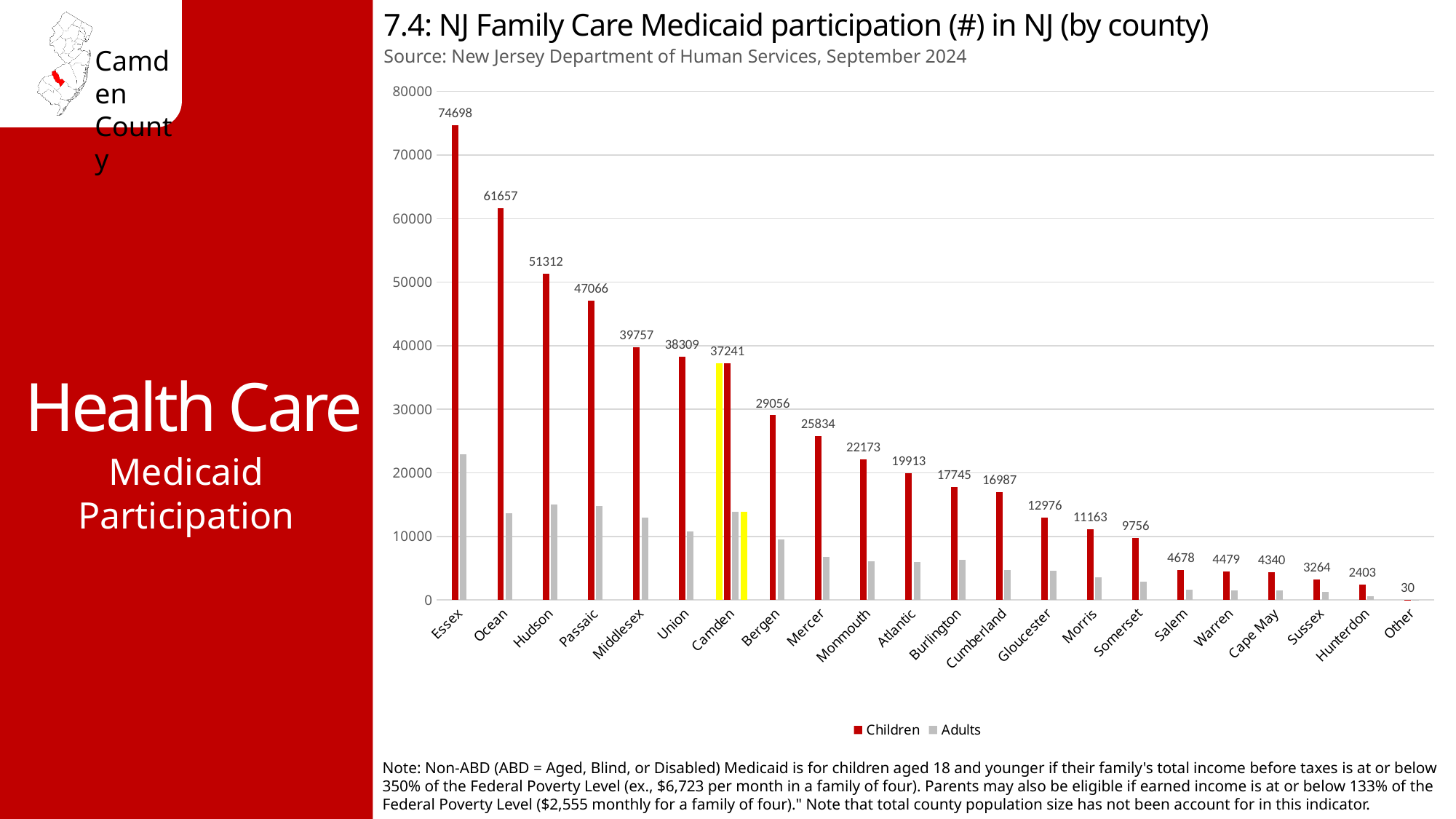
What is the Children value for Gloucester? 12976 Which county has the highest Children value? Essex What is the Children value for Camden? 37241 What kind of chart is shown on the slide? Bar chart Is the Adults value for Essex greater or less than 20000? greater How many categories are shown on the x axis? 22 How many series does the legend list? 2 Which has a larger Children value, Bergen or Mercer? Bergen What is the difference between the Children values for Ocean and Hudson? 10345 Is the Adults value for Camden greater or less than 20000? less Which category has the lowest Children value? Other What is the Children value for Essex? 74698